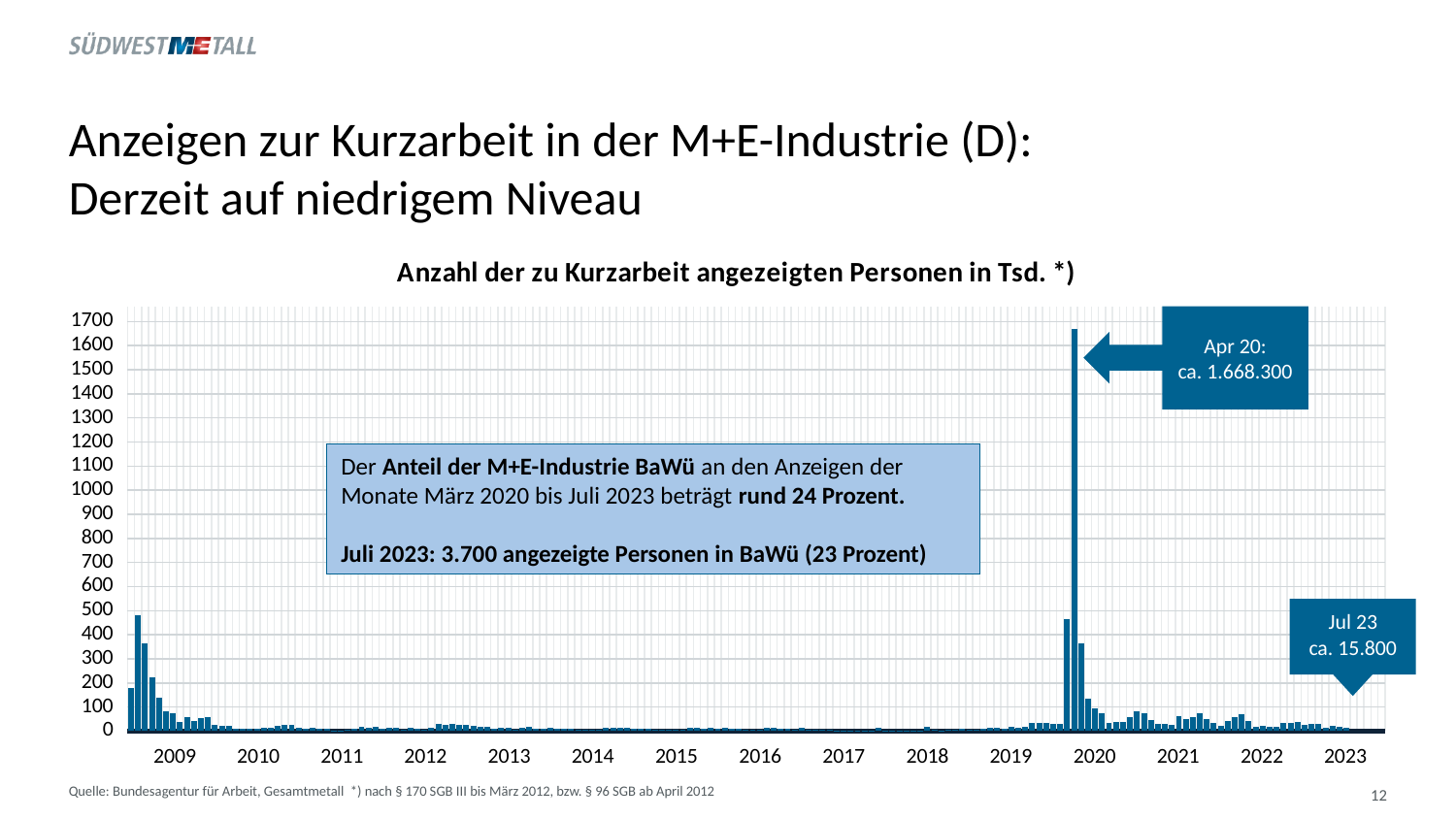
Is the highest bar in 2020 greater or less than 1500? greater What is the title of the chart? Anzahl der zu Kurzarbeit angezeigten Personen in Tsd. *) How many year labels are shown on the x axis? 15 Do the values rise or fall from the start of 2009 to 2010? fall Which is larger: the peak bar in 2020 or the peak bar in 2009? the peak bar in 2020 Is the highest bar in 2009 greater or less than 500? less What value does the callout label give for Jul 23? ca. 15.800 What is the highest value shown on the y axis? 1700 In which year does the chart reach its highest value? 2020 Is the highest bar in 2009 greater or less than 400? greater What kind of chart is shown on the slide? bar chart What value does the callout give for Apr 20? ca. 1.668.300